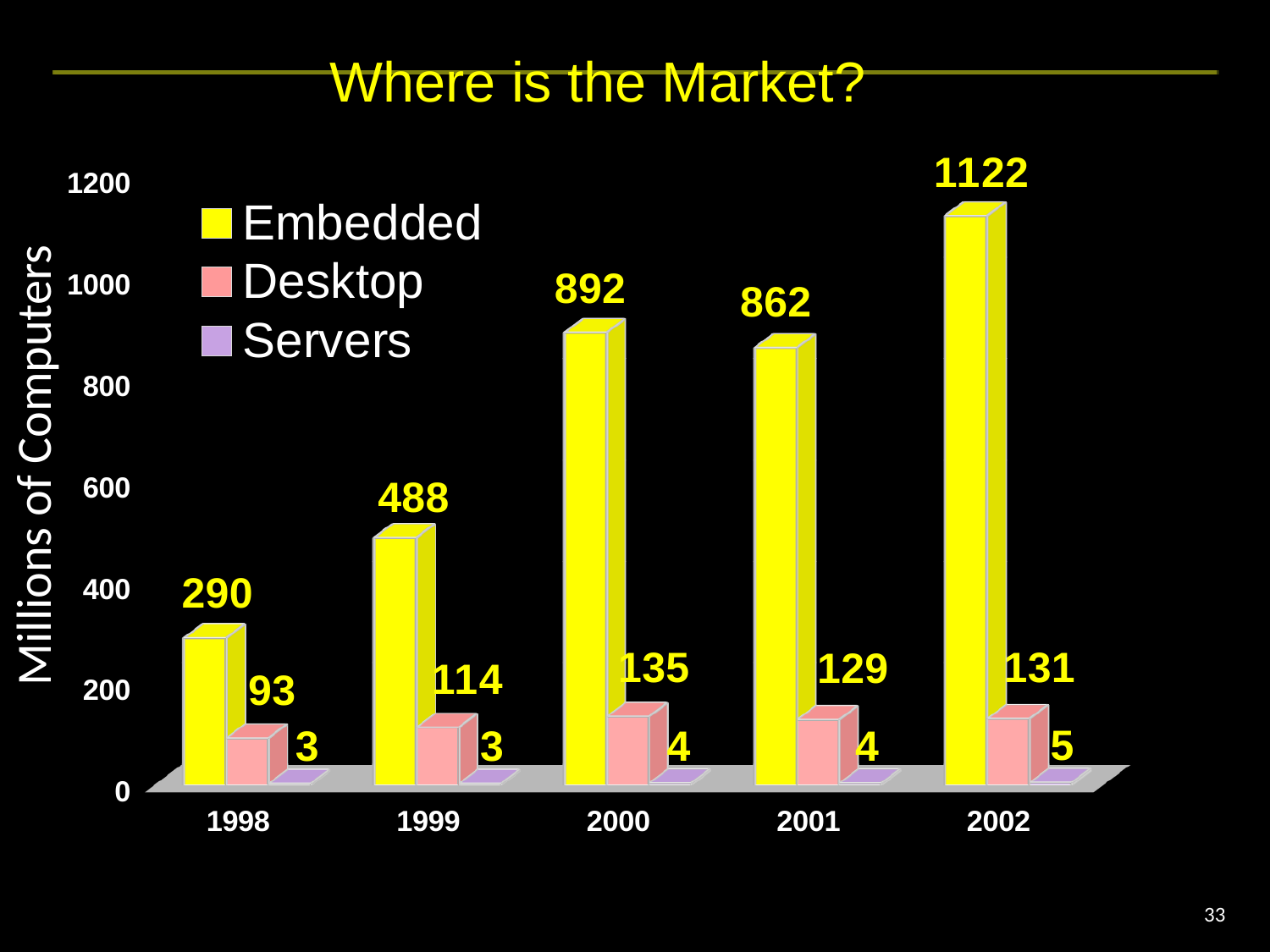
What is the Desktop value for 1999? 114 Does the Embedded value rise or fall from 1998 to 1999? rise How many series does the legend list? 3 What is the Servers value for 2002? 5 What is the difference between the Embedded values for 2000 and 2001? 30 What is the Embedded value for 2002? 1122 How many years are shown on the x axis? 5 Which year has the highest Embedded value? 2002 What kind of chart is shown? bar chart Which year has the lowest Desktop value? 1998 Which is larger, the Desktop value for 2000 or for 2001? 2000 What is the y-axis label of the chart? Millions of Computers